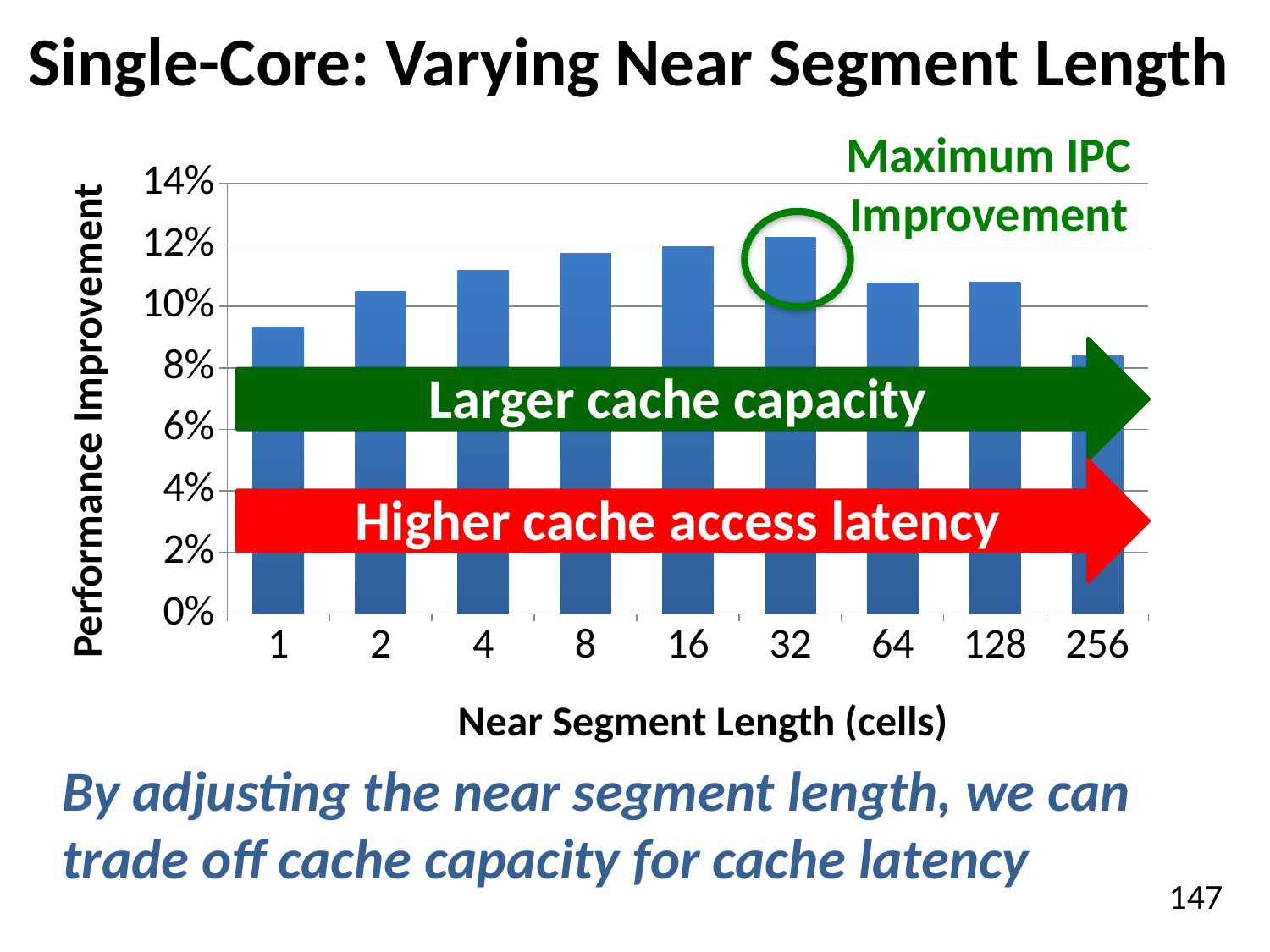
Which has a larger performance improvement: a near segment length of 1 or 16? 16 What is the label of the x axis? Near Segment Length (cells) Is the performance improvement for a near segment length of 64 greater or less than 10%? greater Which near segment length has the highest performance improvement? 32 How does performance improvement change as near segment length increases from 1 to 256? rises up to 32, then falls Is the performance improvement for a near segment length of 256 greater or less than 10%? less Which has a larger performance improvement: a near segment length of 32 or 256? 32 What kind of chart is shown on the slide? bar chart Which near segment length has the lowest performance improvement? 256 Is the performance improvement for a near segment length of 8 greater or less than 12%? less How many near segment length categories are plotted on the x axis? 9